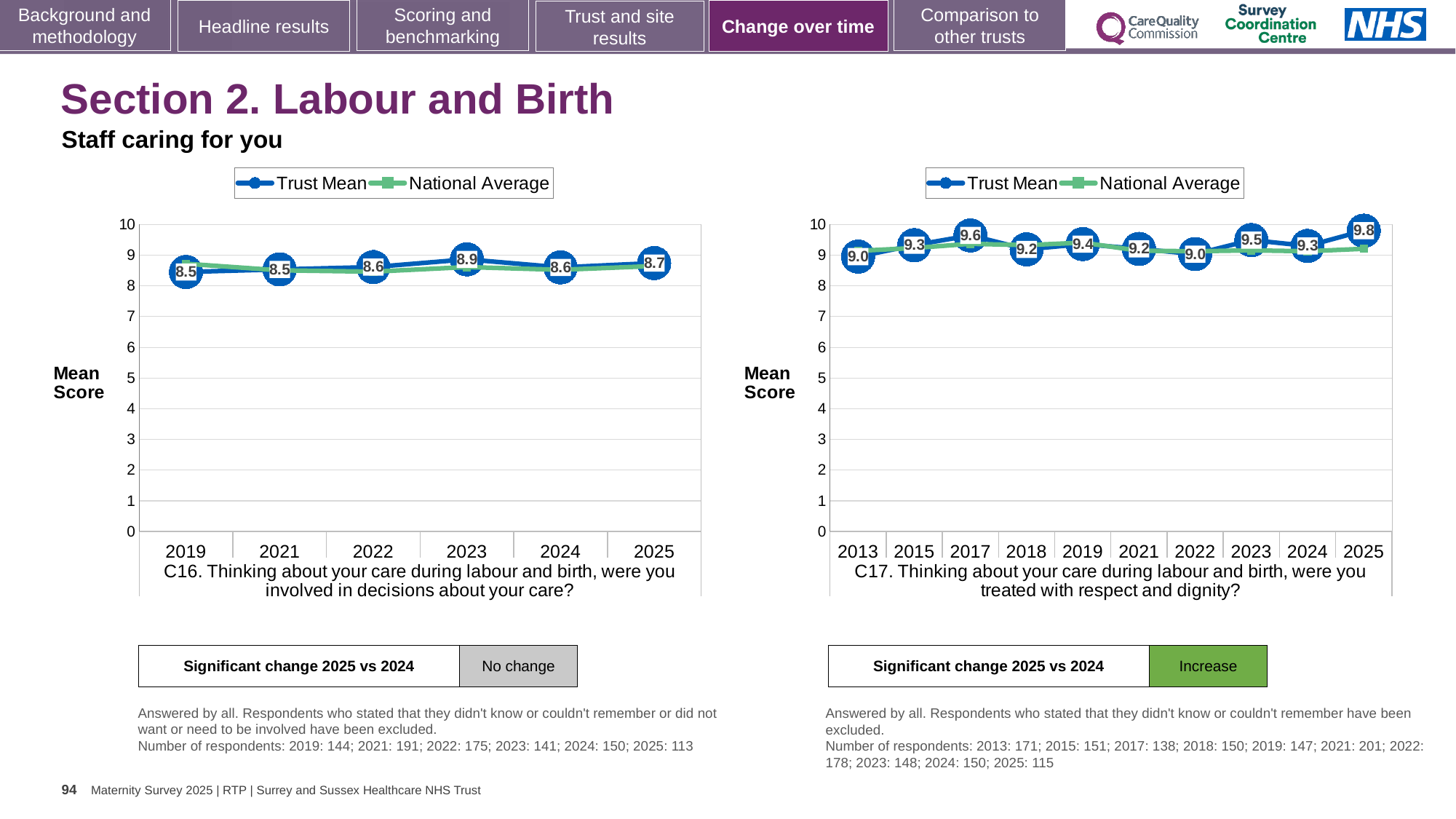
How many years are plotted on the C17 chart (right)? 10 How many years are plotted on the C16 chart (left)? 6 On the C17 chart (right), which year has the highest Trust Mean score? 2025 How many series does the legend of the C16 chart (left) list? 2 On the C16 chart (left), which year has the highest Trust Mean score? 2023 On the C17 chart (right), what is the difference between the Trust Mean scores for 2025 and 2024? 0.5 On the C16 chart (left), what is the Trust Mean score for 2023? 8.9 On the C17 chart (right), is the National Average value for 2025 greater or less than 9? greater On the C17 chart (right), what is the Trust Mean score for 2025? 9.8 On the C17 chart (right), what is the Trust Mean score for 2017? 9.6 What kind of chart is the C17 chart (right)? line chart On the C16 chart (left), is the Trust Mean score for 2023 larger or smaller than the score for 2024? larger